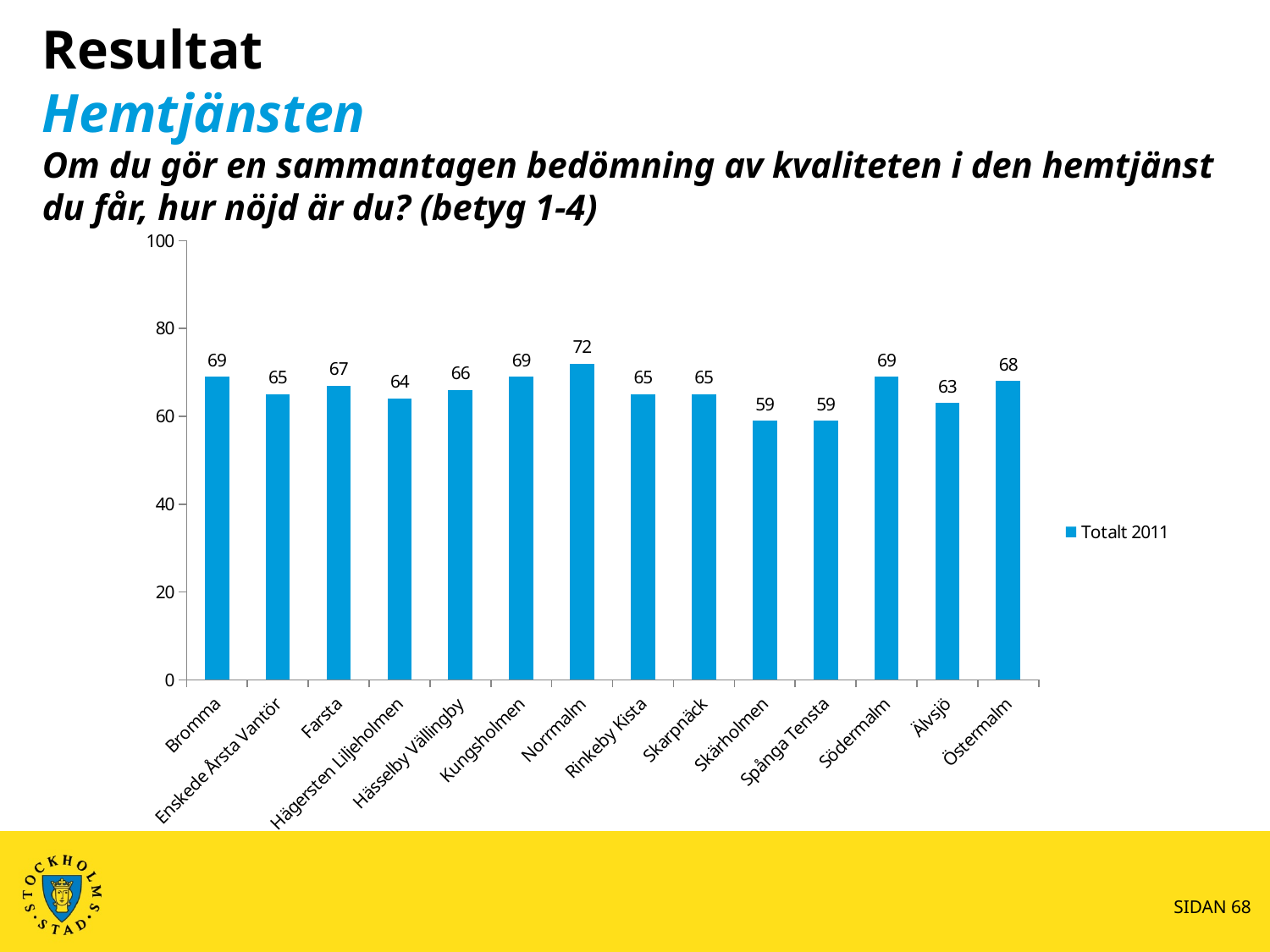
Which is larger, the value for Farsta or the value for Hägersten Liljeholmen? Farsta What is the value for Norrmalm? 72 What is the difference between the values for Bromma and Älvsjö? 6 How many categories are shown on the x axis? 14 Which two categories share the lowest value? Skärholmen and Spånga Tensta What is the value for Hässelby Vällingby? 66 What is the value for Älvsjö? 63 What is the difference between the values for Norrmalm and Skärholmen? 13 Which category has the highest value? Norrmalm What kind of chart is shown on the slide? Bar chart What is the value for Östermalm? 68 How many series does the legend list? 1